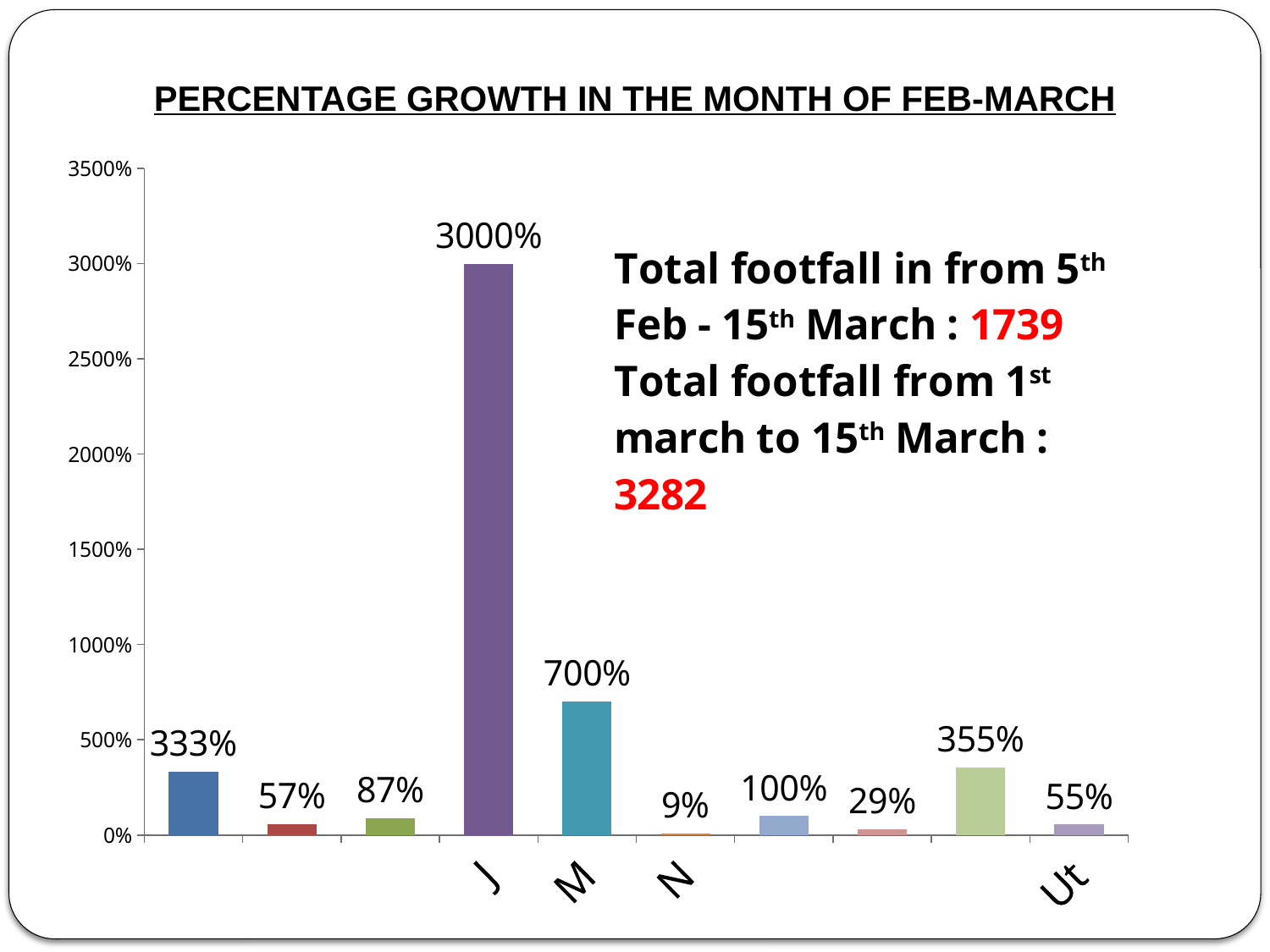
Which labelled category has the highest percentage growth? J Which has a larger percentage growth, M or Ut? M What is the difference between the percentage growth for J and for M? 2300% Is the value for M greater or less than 500%? greater What is the percentage growth value shown for category J? 3000% What is the percentage growth value shown for category M? 700% What is the difference between the percentage growth for M and for N? 691% What is the percentage growth value shown for category N? 9% How many bars are plotted in the chart? 10 Which labelled category has the lowest percentage growth? N What type of chart is shown on the slide? Bar chart What is the percentage growth value shown for category Ut? 55%